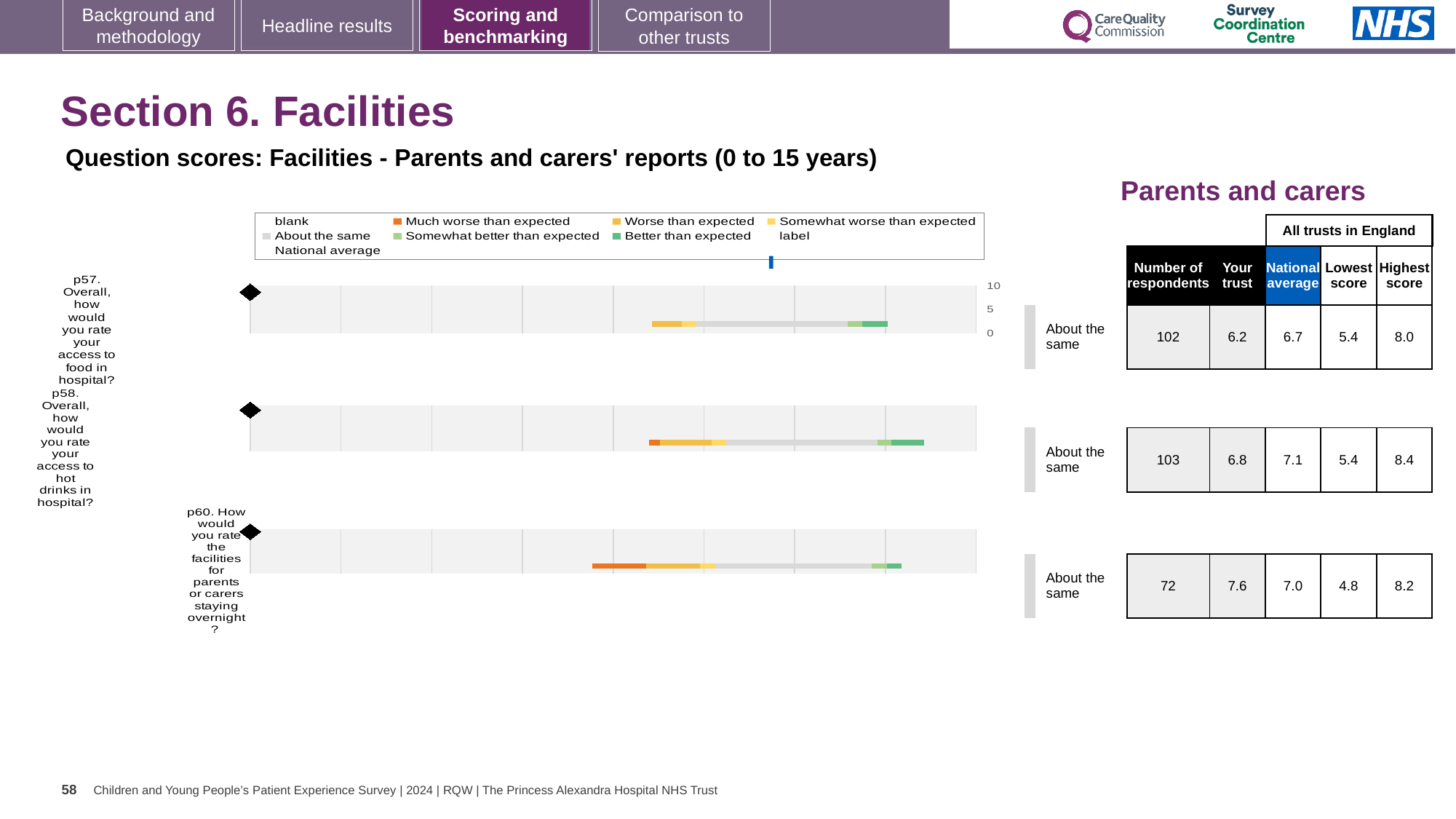
How many questions are plotted in the Facilities charts on this slide? 3 In the table next to the charts, how many respondents answered p60 (facilities for parents or carers staying overnight)? 72 What colour does the legend use for 'Much worse than expected'? orange For p57, what is the difference between the Highest score and the Lowest score across all trusts in England? 2.6 Which question has the highest 'Your trust' score in the table? p60 In the table next to the charts, what is the National average for p58 (access to hot drinks in hospital)? 7.1 What benchmark category is shown for p58 next to its chart? About the same What is the highest value shown on the score axis of the charts? 10 In the table next to the charts, what is the 'Your trust' score for p57 (access to food in hospital)? 6.2 For p60, which is larger: the 'Your trust' score or the National average? Your trust What kind of chart is used to show the question scores for p57, p58 and p60? bar chart How many entries does the legend above the charts list? 9